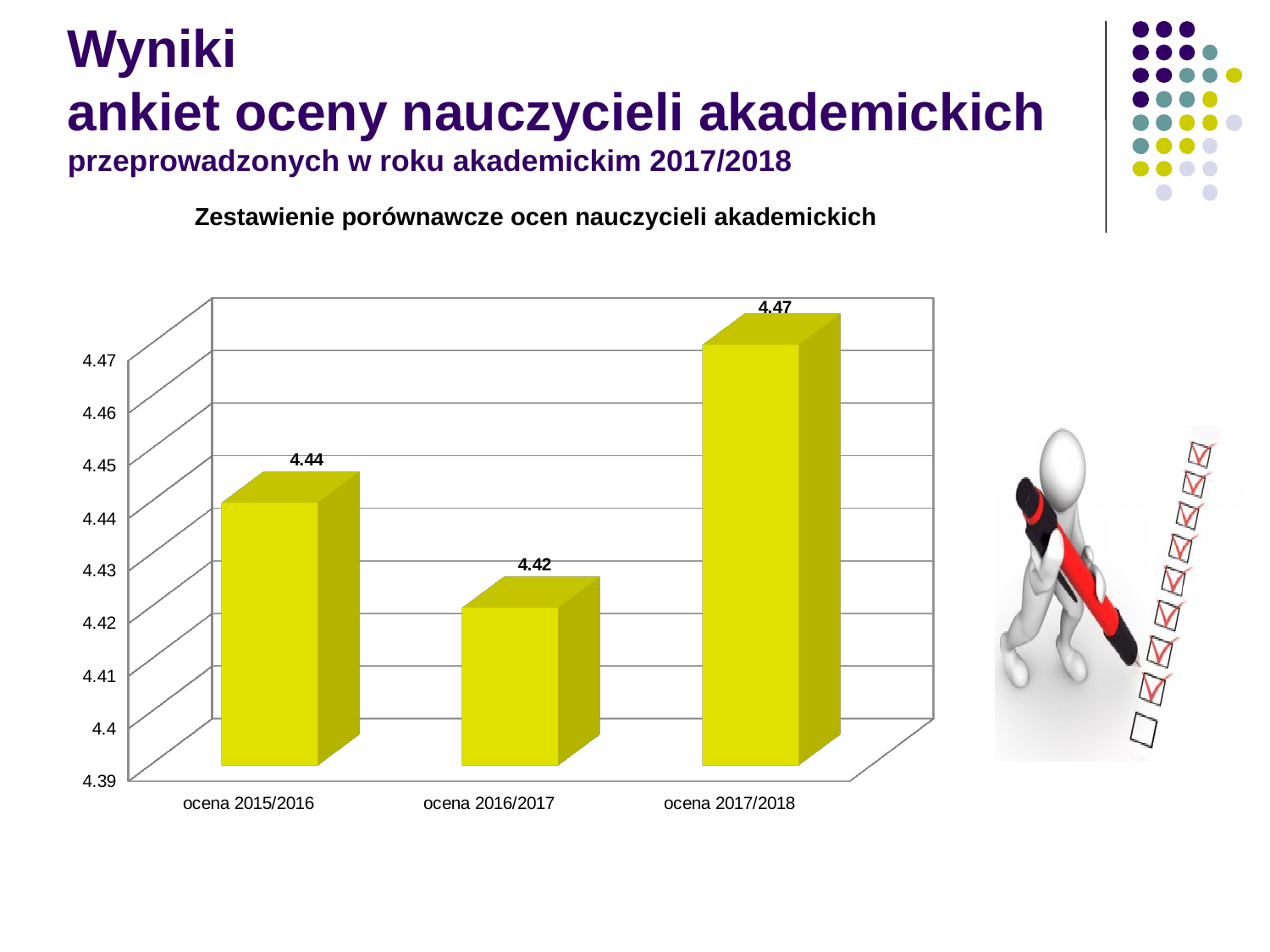
What is the difference between the values for ocena 2015/2016 and ocena 2016/2017? 0.02 Which is larger, the value for ocena 2015/2016 or ocena 2017/2018? ocena 2017/2018 Which category has the highest value? ocena 2017/2018 Is the value for ocena 2016/2017 greater or less than 4.43? less What is the value for ocena 2017/2018? 4.47 How many categories are shown on the chart? 3 What is the title of the chart? Zestawienie porównawcze ocen nauczycieli akademickich What is the value for ocena 2015/2016? 4.44 Which category has the lowest value? ocena 2016/2017 What is the difference between the values for ocena 2017/2018 and ocena 2016/2017? 0.05 What kind of chart is shown on the slide? bar chart What is the value for ocena 2016/2017? 4.42